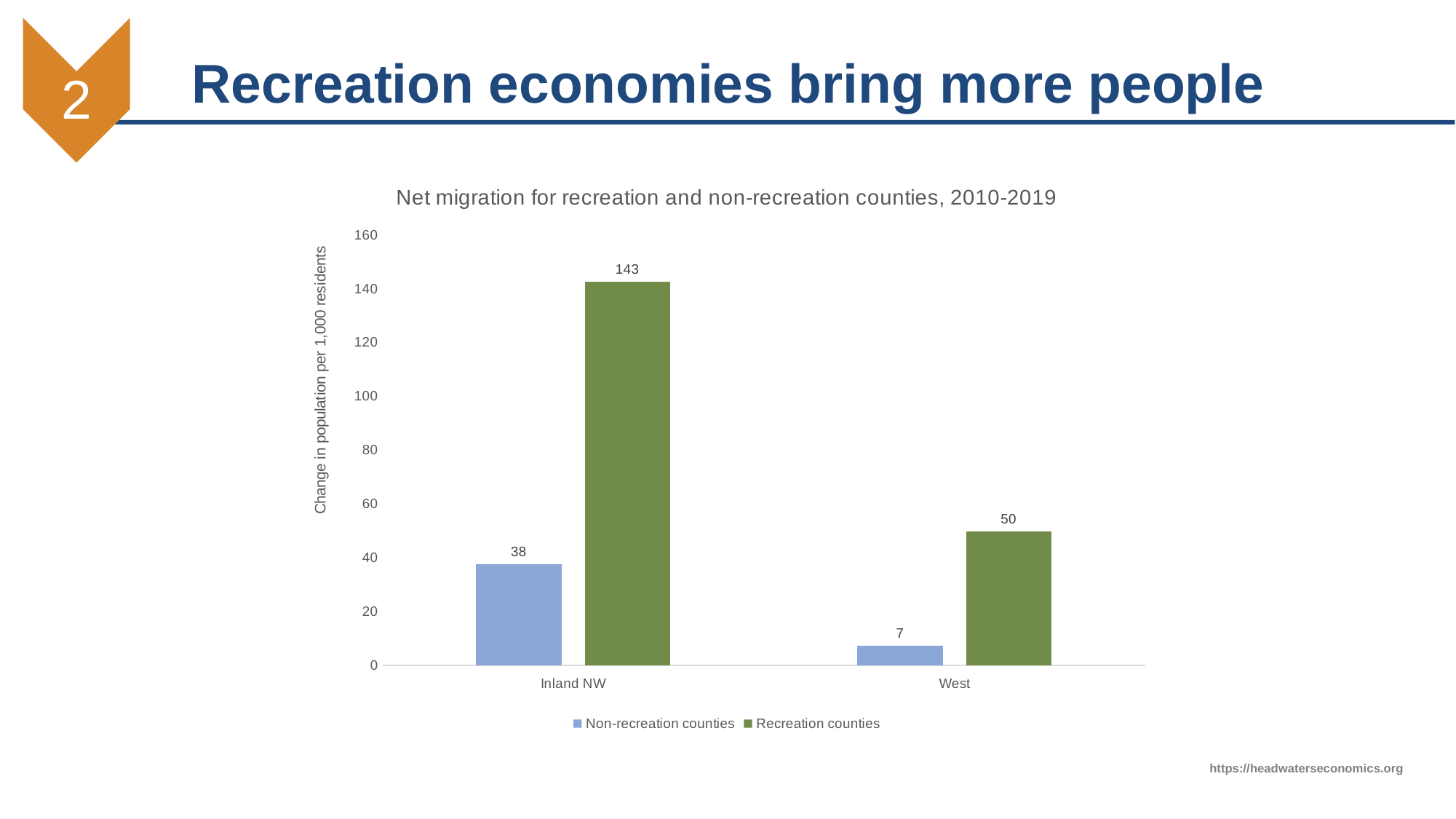
What is the value for Non-recreation counties in Inland NW? 38 What is the title of the chart? Net migration for recreation and non-recreation counties, 2010-2019 How many series does the legend list? 2 What is the net migration value for Recreation counties in Inland NW? 143 What is the net migration value for Non-recreation counties in West? 7 Which bar has the highest value on the chart? Recreation counties, Inland NW What is the difference between Recreation counties and Non-recreation counties in West? 43 Which is larger: Non-recreation counties in Inland NW or Recreation counties in West? Recreation counties in West What kind of chart is shown on the slide? Bar chart What is the difference between Recreation counties and Non-recreation counties in Inland NW? 105 Which bar has the lowest value on the chart? Non-recreation counties, West What is the value for Recreation counties in West? 50